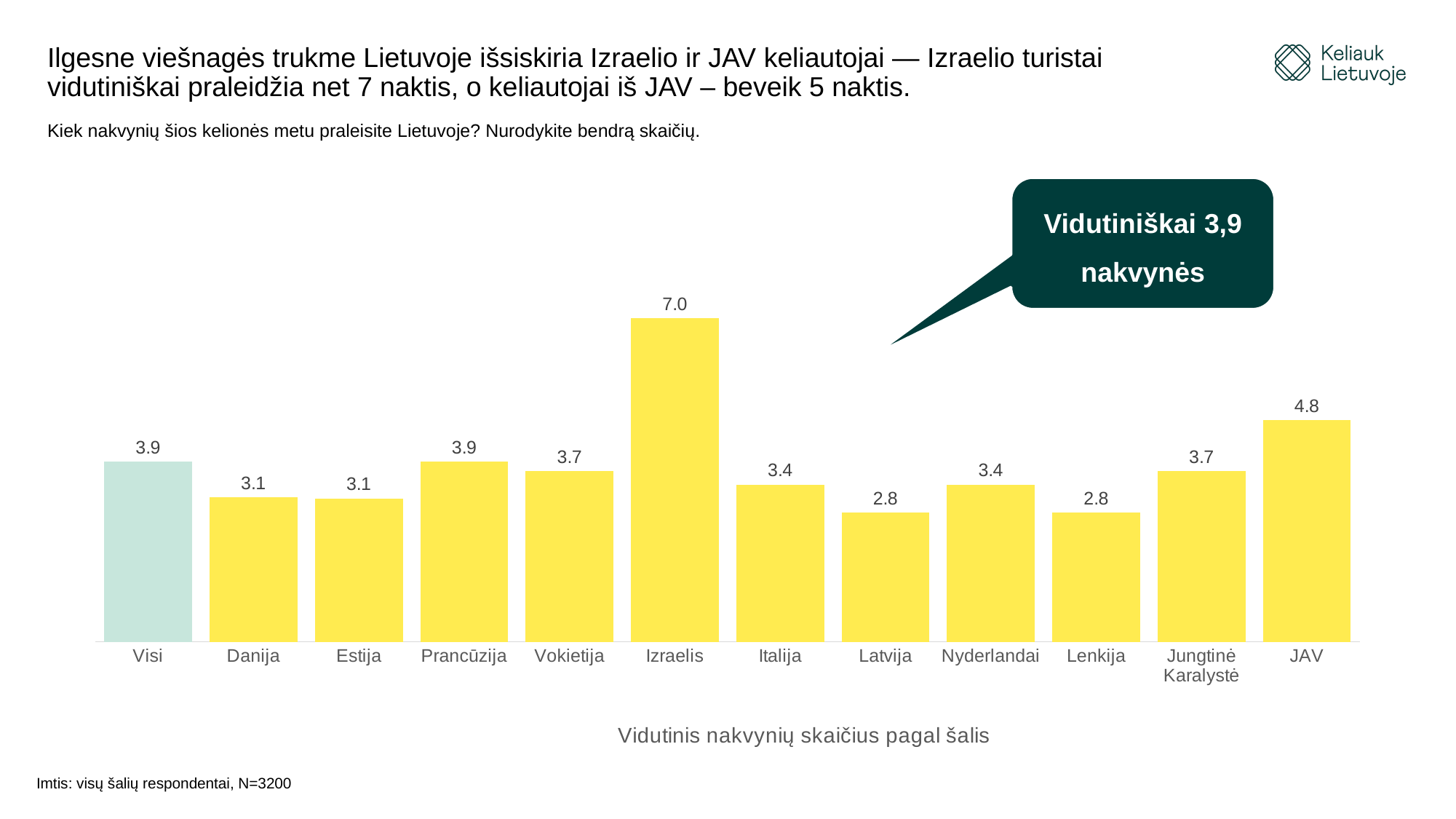
What is the difference between the values for Izraelis and JAV? 2.2 What is the average number of nights for Izraelis? 7.0 What type of chart is shown on the slide? Bar chart How many bars are shown in the chart? 12 What is the value shown for Visi? 3.9 Which categories have the lowest value in the chart? Latvija and Lenkija What is the value shown for Jungtinė Karalystė? 3.7 What is the title shown below the chart? Vidutinis nakvynių skaičius pagal šalis What is the difference between the values for Prancūzija and Danija? 0.8 Which has a higher value, Vokietija or Italija? Vokietija What is the average number of nights for JAV? 4.8 Which country has the highest average number of nights? Izraelis